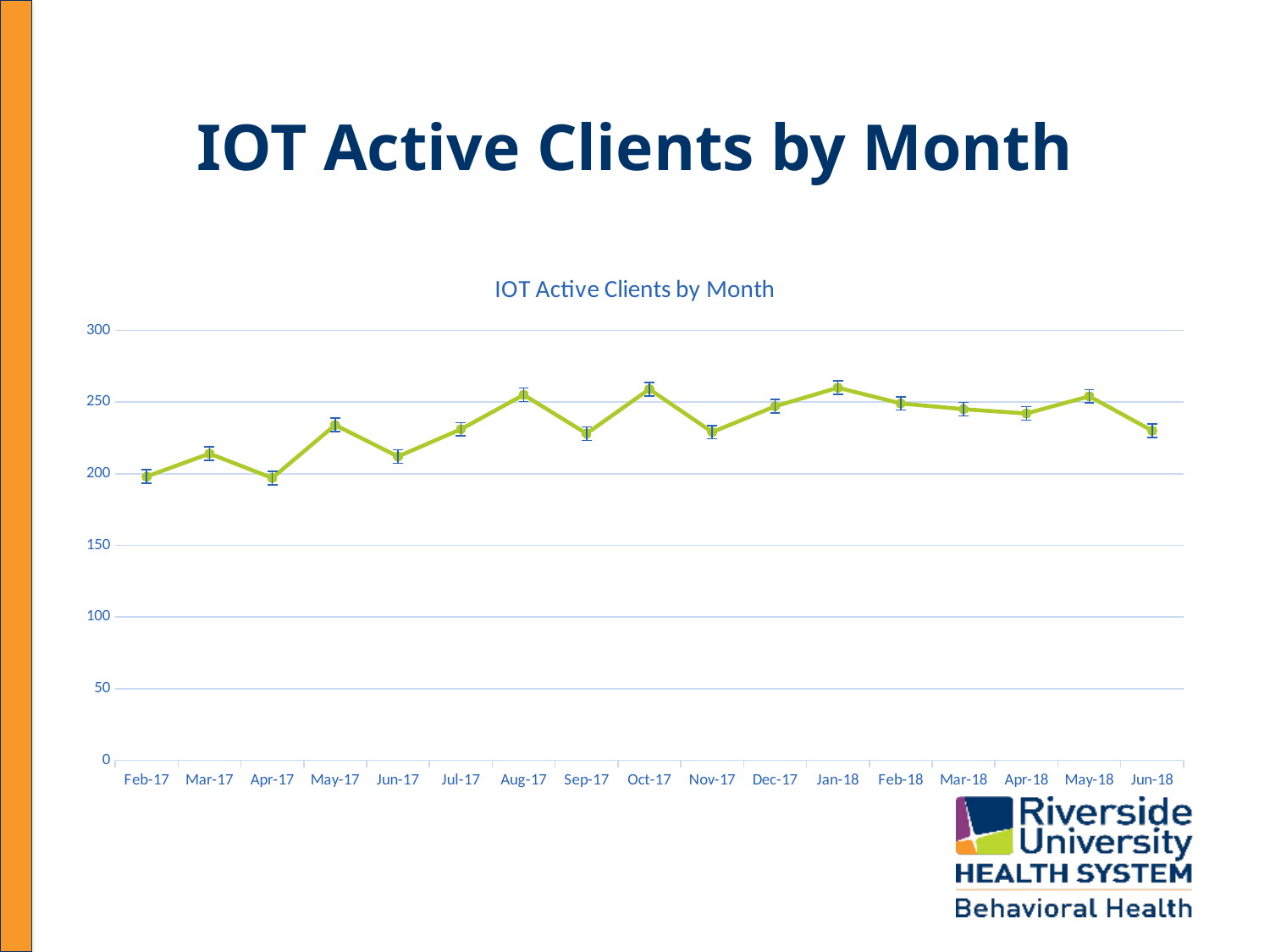
Does the line rise or fall from Jan-18 to Apr-18? fall Which month has the larger value, Jan-18 or Jun-18? Jan-18 What is the title of the chart? IOT Active Clients by Month Is the value for Sep-17 greater or less than 250? less Is the value for Jun-17 greater or less than 200? greater Which month has the larger value, Aug-17 or Sep-17? Aug-17 Which month has the larger value, May-17 or Jun-17? May-17 What kind of chart is shown on the slide? line chart How many months are plotted on the x axis of the chart? 17 Is the value for Jan-18 greater or less than 250? greater